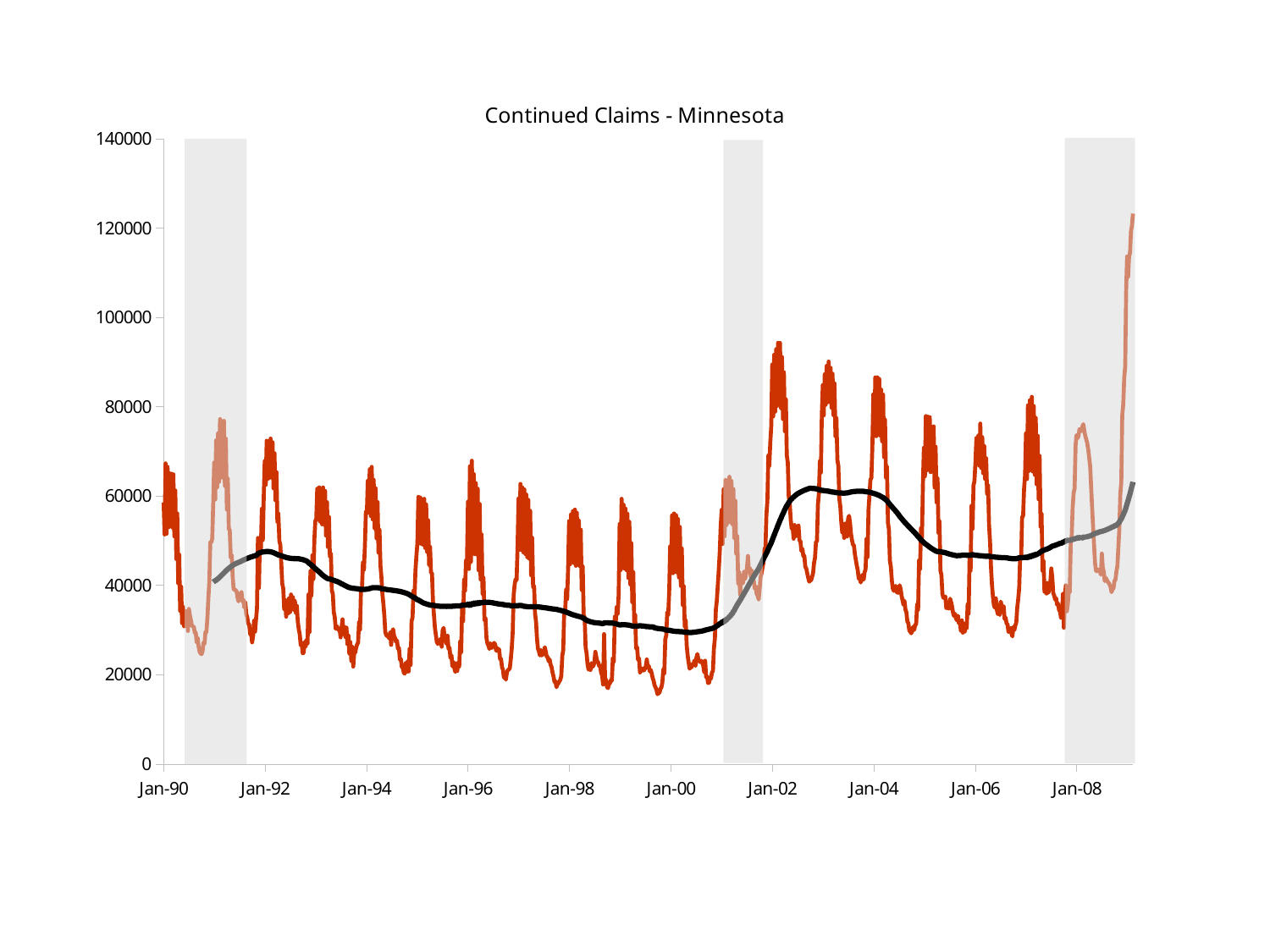
Is the peak of the red line just after Jan-02 higher or lower than the peak just after Jan-92? higher What is the title of the chart? Continued Claims - Minnesota How many shaded vertical bands are drawn on the chart? 3 Is the peak value of the red line at the far right end of the chart (after Jan-08) greater or less than 100000? greater Is the black smoothed line around Jan-98 greater or less than 40000? less What is the highest value shown on the vertical axis? 140000 How many labelled tick marks are there on the horizontal axis? 10 Does the black smoothed line rise or fall between Jan-92 and Jan-00? fall Is the lowest point of the red line between Jan-98 and Jan-00 greater or less than 20000? less What kind of chart is shown on the slide? line chart